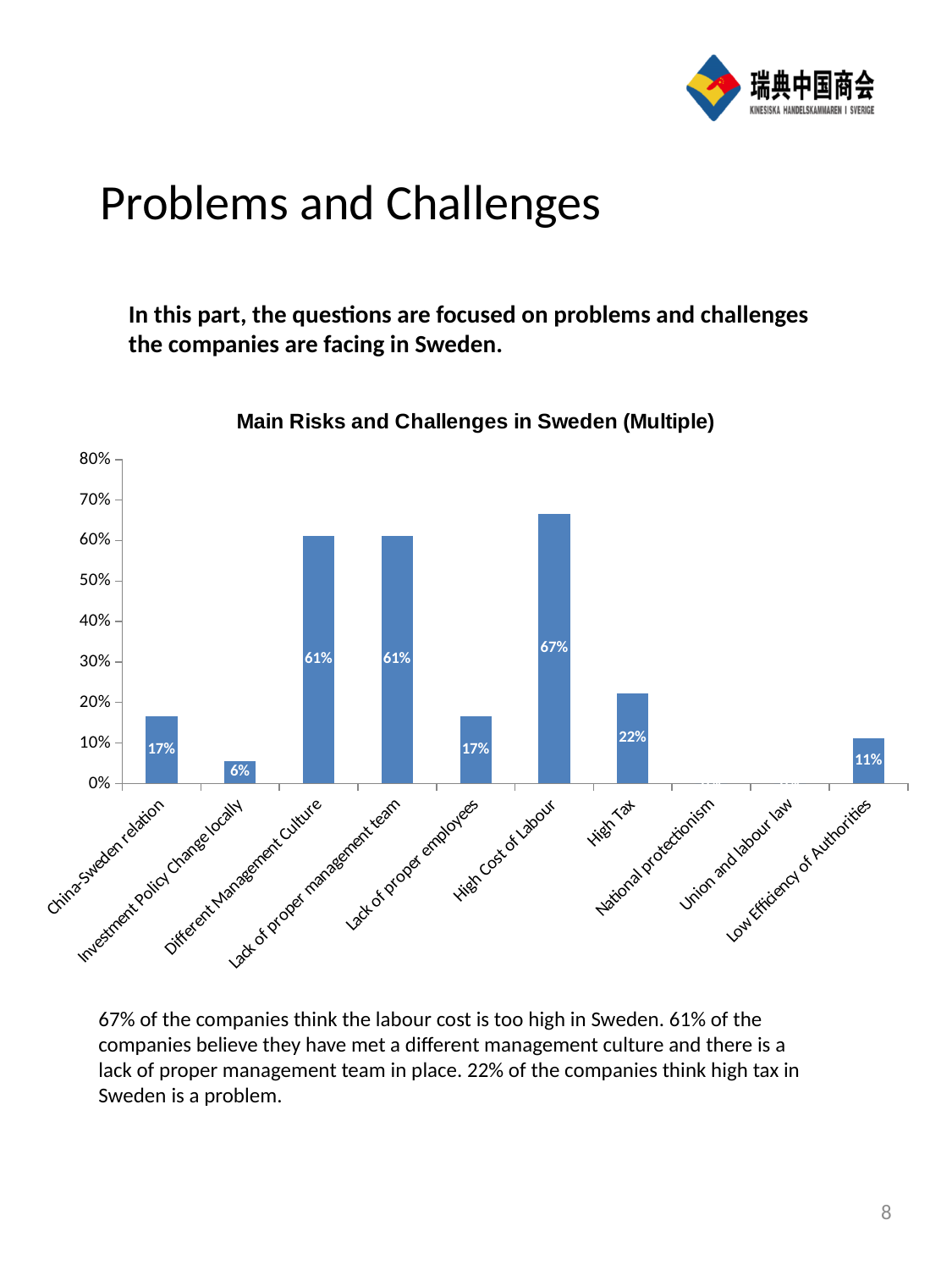
What is the difference between the values for Lack of proper management team and Lack of proper employees? 44% How many categories are shown on the x axis? 10 Which is larger, the value for High Tax or the value for Low Efficiency of Authorities? High Tax What is the difference between the values for High Cost of Labour and High Tax? 45% What is the value for High Tax? 22% What is the value for High Cost of Labour? 67% What is the value for Different Management Culture? 61% What is the value for Investment Policy Change locally? 6% What kind of chart is shown on the slide? Bar chart Which category has the highest value? High Cost of Labour What is the value for Low Efficiency of Authorities? 11% Is the value for China-Sweden relation greater or less than 20%? less